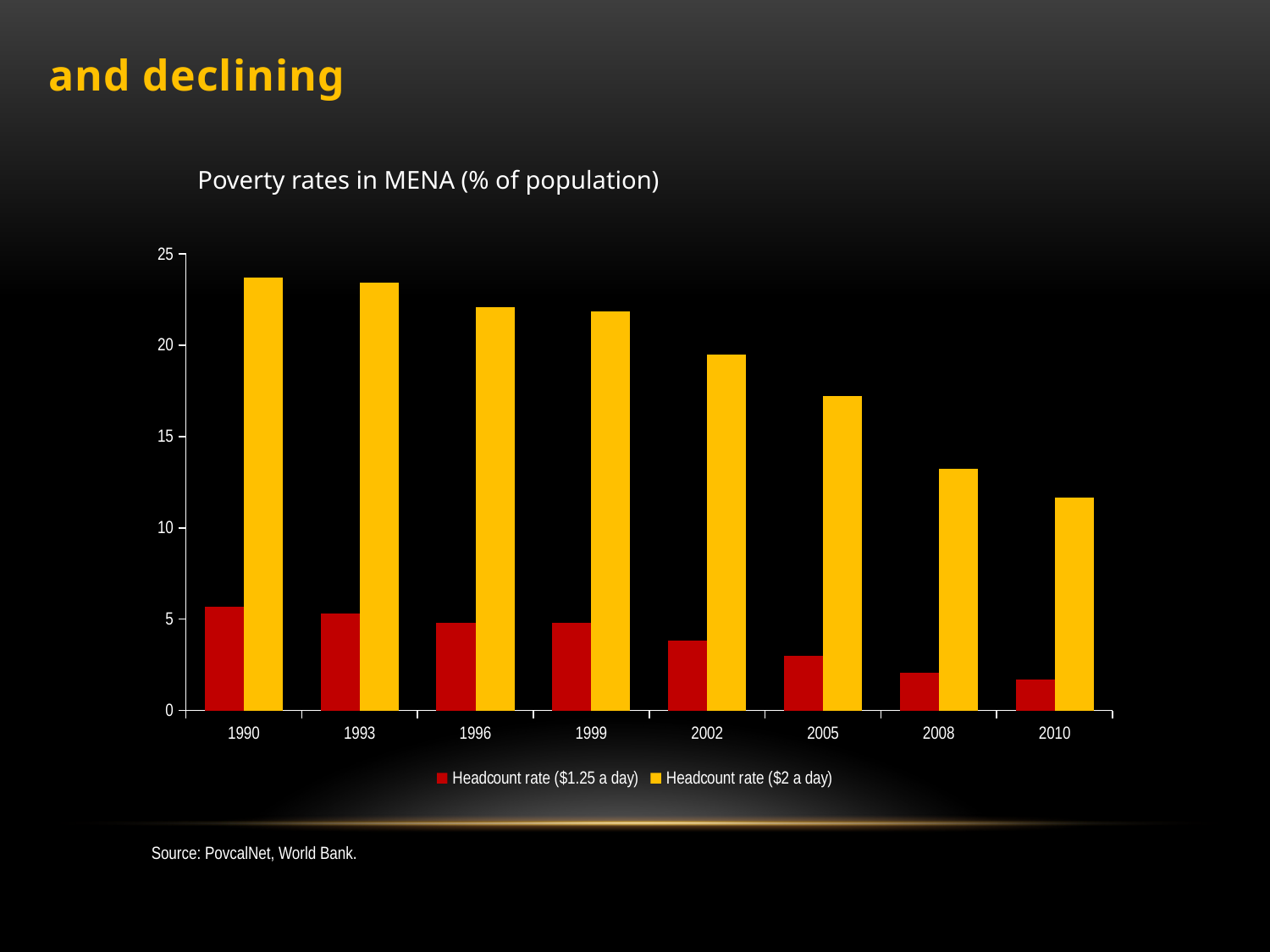
Is the value for Headcount rate ($2 a day) in 2002 greater or less than 20? less How many years are shown on the x axis? 8 Which year has the lowest value for Headcount rate ($1.25 a day)? 2010 Is the value for Headcount rate ($2 a day) in 2008 greater or less than 15? less Do the values for Headcount rate ($2 a day) rise or fall from 1990 to 2010? fall Is the value for Headcount rate ($1.25 a day) in 1990 greater or less than 5? greater Which is larger, Headcount rate ($2 a day) in 2005 or in 2008? 2005 What kind of chart is shown on the slide? bar chart What is the title of the chart? Poverty rates in MENA (% of population) How many series does the legend list? 2 Which year has the lowest value for Headcount rate ($2 a day)? 2010